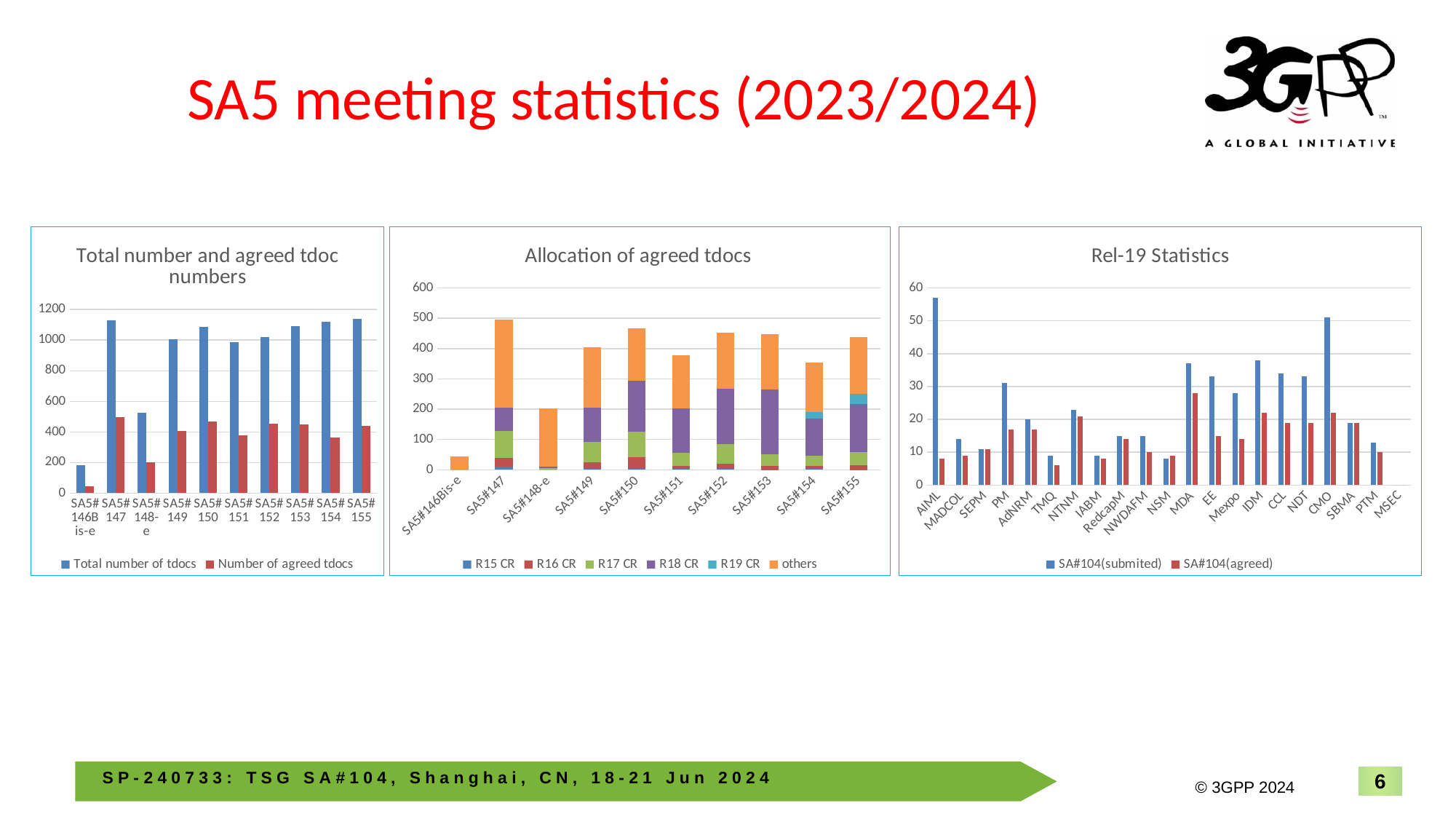
In the "Rel-19 Statistics" chart, is the SA#104(submited) value for IDM greater or less than 30? greater In the "Total number and agreed tdoc numbers" chart, is the total number of tdocs for SA5#148-e greater or less than 400? greater What type of chart is the "Total number and agreed tdoc numbers" chart? bar chart How many series does the legend of the "Allocation of agreed tdocs" chart list? 6 In the "Total number and agreed tdoc numbers" chart, how many meetings are shown on the x axis? 10 In the "Total number and agreed tdoc numbers" chart, is the number of agreed tdocs for SA5#154 greater or less than 400? less In the "Rel-19 Statistics" chart, which category has the highest SA#104(submited) value? AIML In the "Allocation of agreed tdocs" chart, which meeting has the tallest stacked bar? SA5#147 In the "Total number and agreed tdoc numbers" chart, which is larger: the number of agreed tdocs for SA5#147 or for SA5#154? SA5#147 In the "Rel-19 Statistics" chart, which category has the highest SA#104(agreed) value? MDA In the "Total number and agreed tdoc numbers" chart, which meeting has the lowest total number of tdocs? SA5#146Bis-e